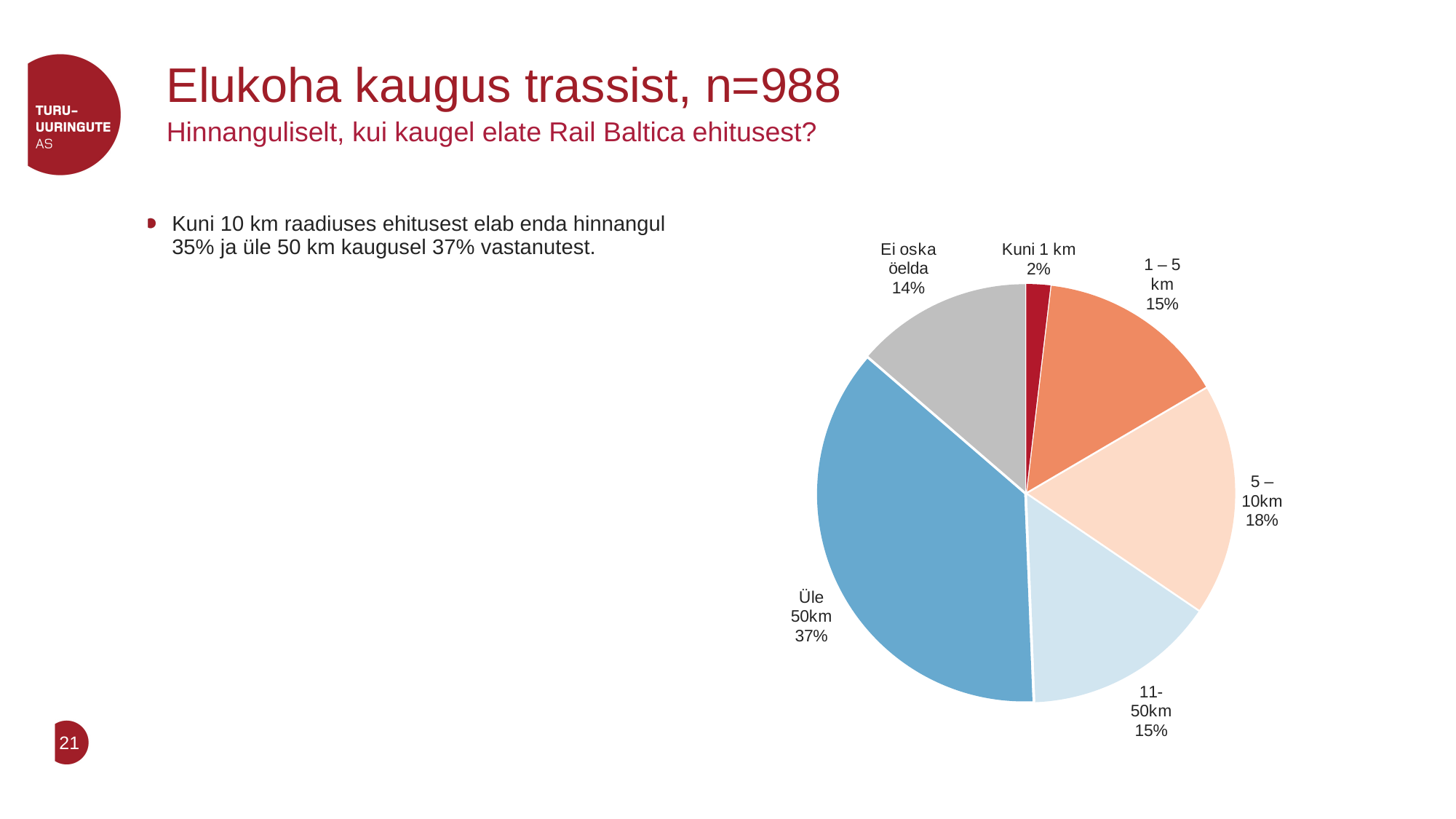
What is the title of the slide containing the pie chart? Elukoha kaugus trassist, n=988 What kind of chart is shown on the slide? pie chart Which category has the smallest share of the pie? Kuni 1 km What is the difference in percentage points between the "Üle 50km" slice and the "5 – 10km" slice? 19 What percentage of respondents answered "Ei oska öelda"? 14% Which slice is larger: "5 – 10km" or "Ei oska öelda"? 5 – 10km Which category has the largest share of the pie? Üle 50km What share of respondents live "Üle 50km" from the construction? 37% What percentage is shown for the "Kuni 1 km" slice? 2% What percentage is shown for the "5 – 10km" slice? 18% What is the combined share of the "1 – 5 km" and "11-50km" slices? 30% How many slices does the pie chart have? 6